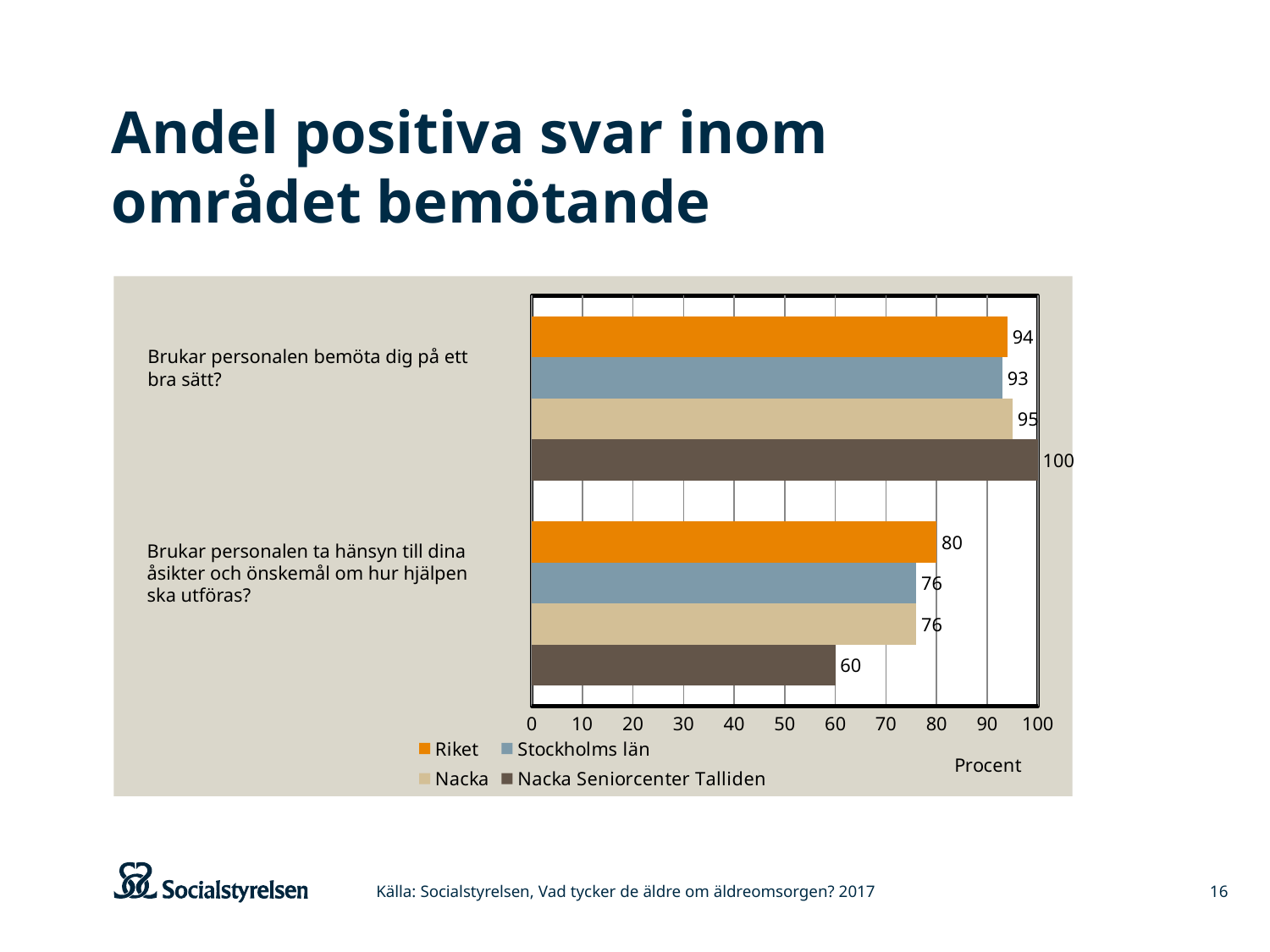
Which series has the highest value for the question "Brukar personalen bemöta dig på ett bra sätt?"? Nacka Seniorcenter Talliden What kind of chart is shown on the slide? Bar chart What is the label of the horizontal axis? Procent What is the value for Nacka Seniorcenter Talliden for the question "Brukar personalen bemöta dig på ett bra sätt?"? 100 What is the value for Riket for the question "Brukar personalen ta hänsyn till dina åsikter och önskemål om hur hjälpen ska utföras?"? 80 Is the value for Nacka for the question "Brukar personalen ta hänsyn till dina åsikter och önskemål om hur hjälpen ska utföras?" greater or less than 80? less For Nacka Seniorcenter Talliden, which question has the larger value: "Brukar personalen bemöta dig på ett bra sätt?" or "Brukar personalen ta hänsyn till dina åsikter och önskemål om hur hjälpen ska utföras?"? Brukar personalen bemöta dig på ett bra sätt? How many series does the legend list? 4 What is the value for Stockholms län for the question "Brukar personalen bemöta dig på ett bra sätt?"? 93 What is the difference between the Riket value and the Nacka Seniorcenter Talliden value for the question "Brukar personalen ta hänsyn till dina åsikter och önskemål om hur hjälpen ska utföras?"? 20 How many questions (categories) are shown on the chart? 2 Which series has the lowest value for the question "Brukar personalen ta hänsyn till dina åsikter och önskemål om hur hjälpen ska utföras?"? Nacka Seniorcenter Talliden